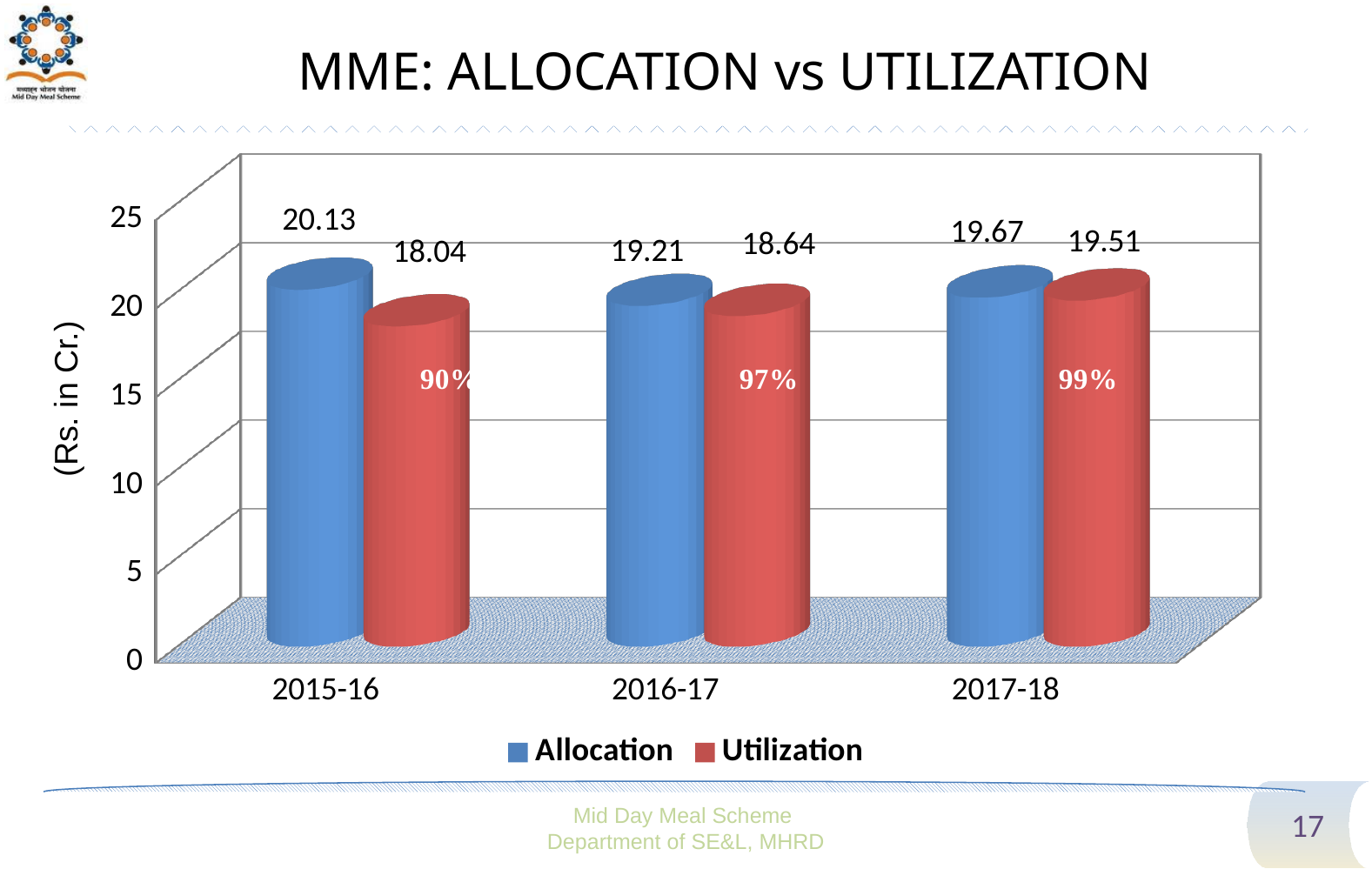
What is the difference between Allocation and Utilization in 2015-16? 2.09 What kind of chart is shown on the slide? bar chart What percentage label is shown on the Utilization bar for 2017-18? 99% What is the Allocation value for 2015-16? 20.13 Which is larger in 2016-17, Allocation or Utilization? Allocation Is the Utilization value for 2015-16 greater or less than 20? less Which year has the highest Allocation? 2015-16 How many years are shown on the x axis? 3 What is the Utilization value for 2017-18? 19.51 What is the Utilization value for 2016-17? 18.64 How many series does the legend list? 2 Which year has the lowest Utilization? 2015-16